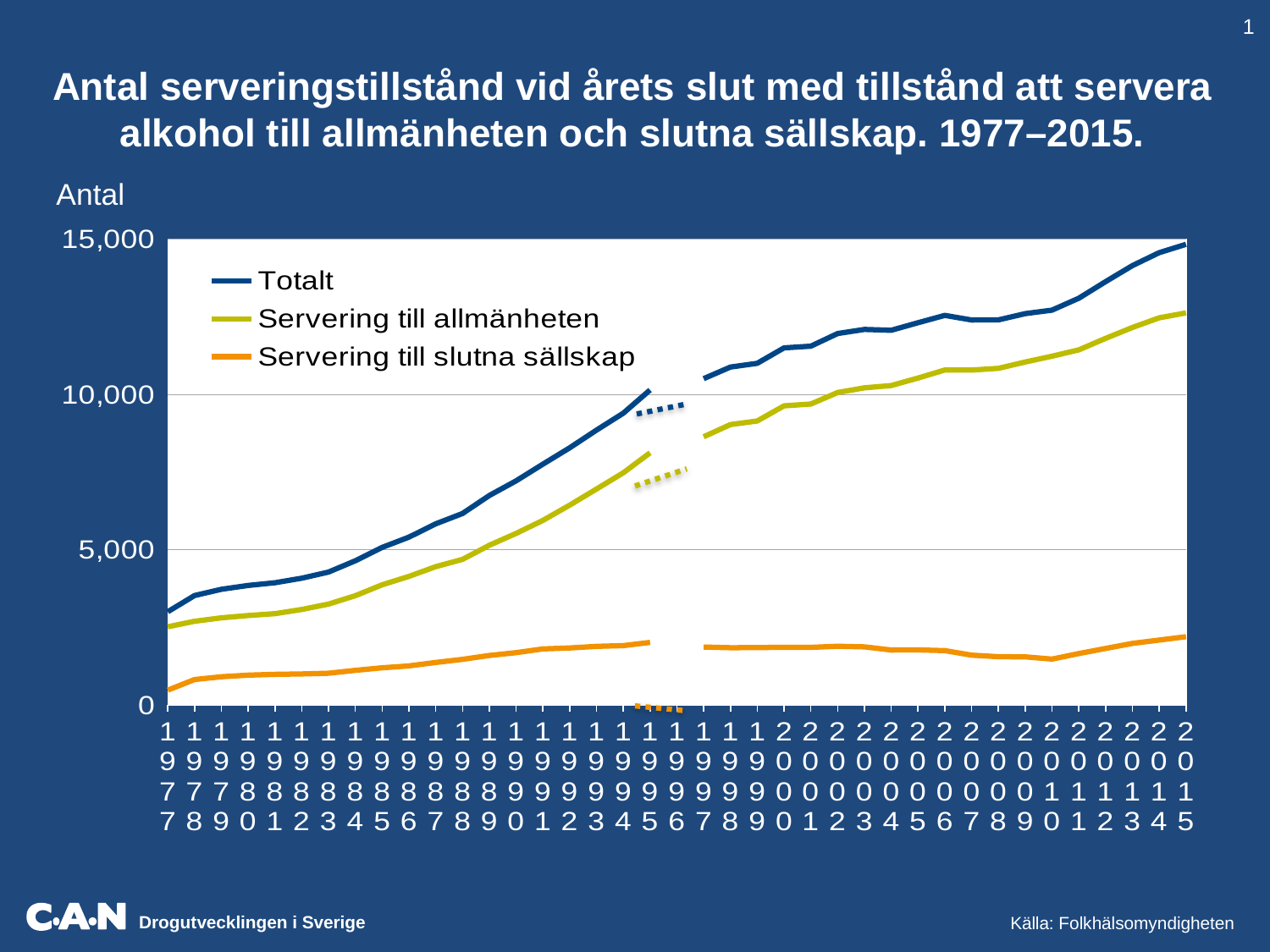
How many series does the legend list? 3 Which series has the lowest values throughout the chart? Servering till slutna sällskap How many years are plotted along the x axis? 39 Which series has the highest values throughout the chart? Totalt In 2015, which is larger: Totalt or Servering till slutna sällskap? Totalt Is the value for Totalt in 2015 greater or less than 10,000? greater Is the value for Servering till slutna sällskap in 2015 greater or less than 5,000? less Does the Totalt series generally rise or fall from 1977 to 2015? rise Is the value for Servering till allmänheten in 2015 greater or less than 10,000? greater What label is shown on the vertical axis of the chart? Antal What kind of chart is shown on the slide? line chart